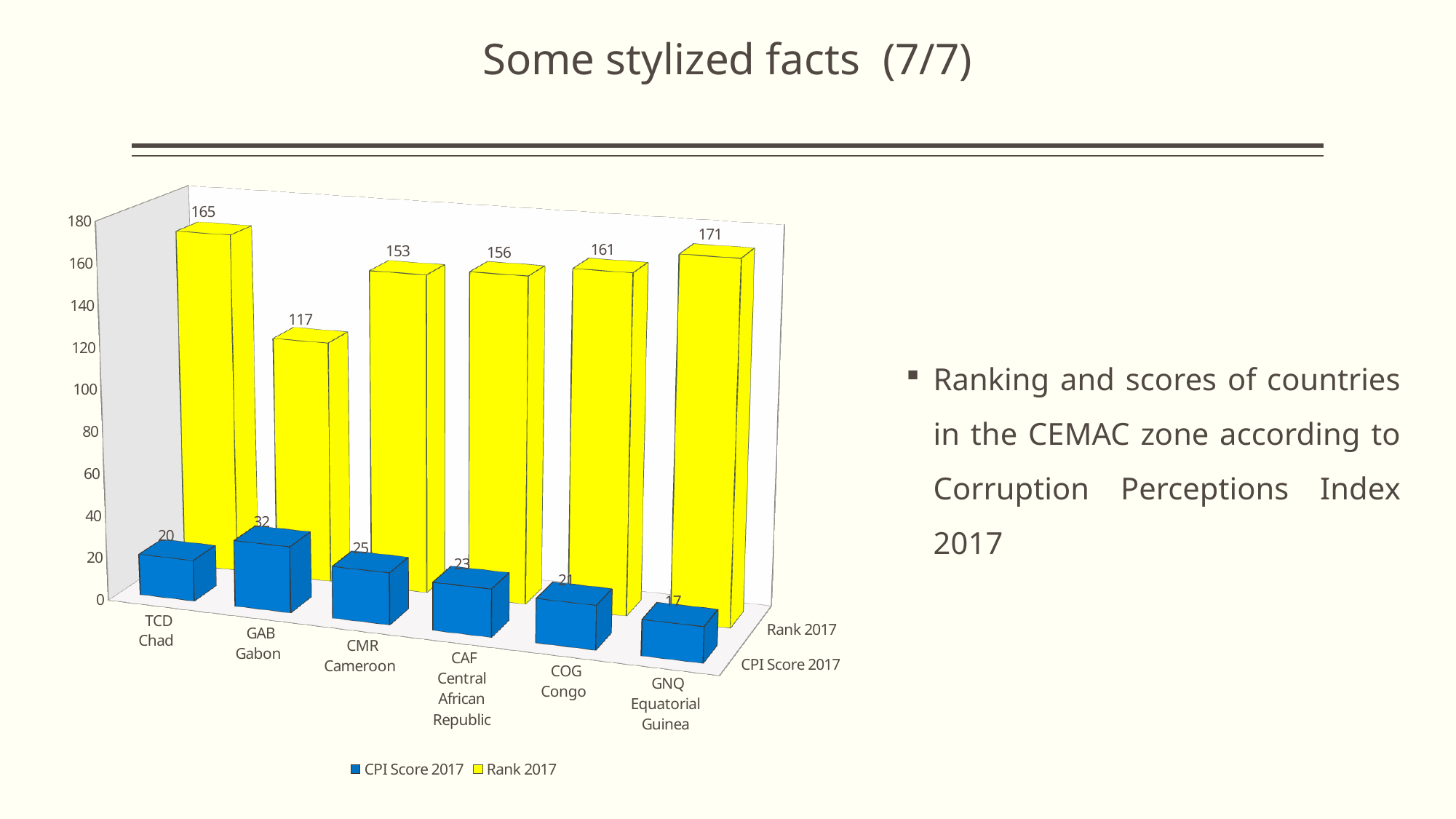
What type of chart is shown on the slide? Bar chart Is the Rank 2017 value for CAF Central African Republic greater or less than 140? greater Which country has the highest CPI Score 2017? GAB Gabon Which country has the lowest CPI Score 2017? GNQ Equatorial Guinea What is the CPI Score 2017 for GNQ Equatorial Guinea? 17 What is the difference between the Rank 2017 values of TCD Chad and GAB Gabon? 48 How many series does the legend list? 2 How many countries are shown on the chart? 6 What is the Rank 2017 value for GAB Gabon? 117 Which is larger, the CPI Score 2017 for CMR Cameroon or for COG Congo? CMR Cameroon Which country has the highest Rank 2017 value? GNQ Equatorial Guinea What is the Rank 2017 value for CMR Cameroon? 153